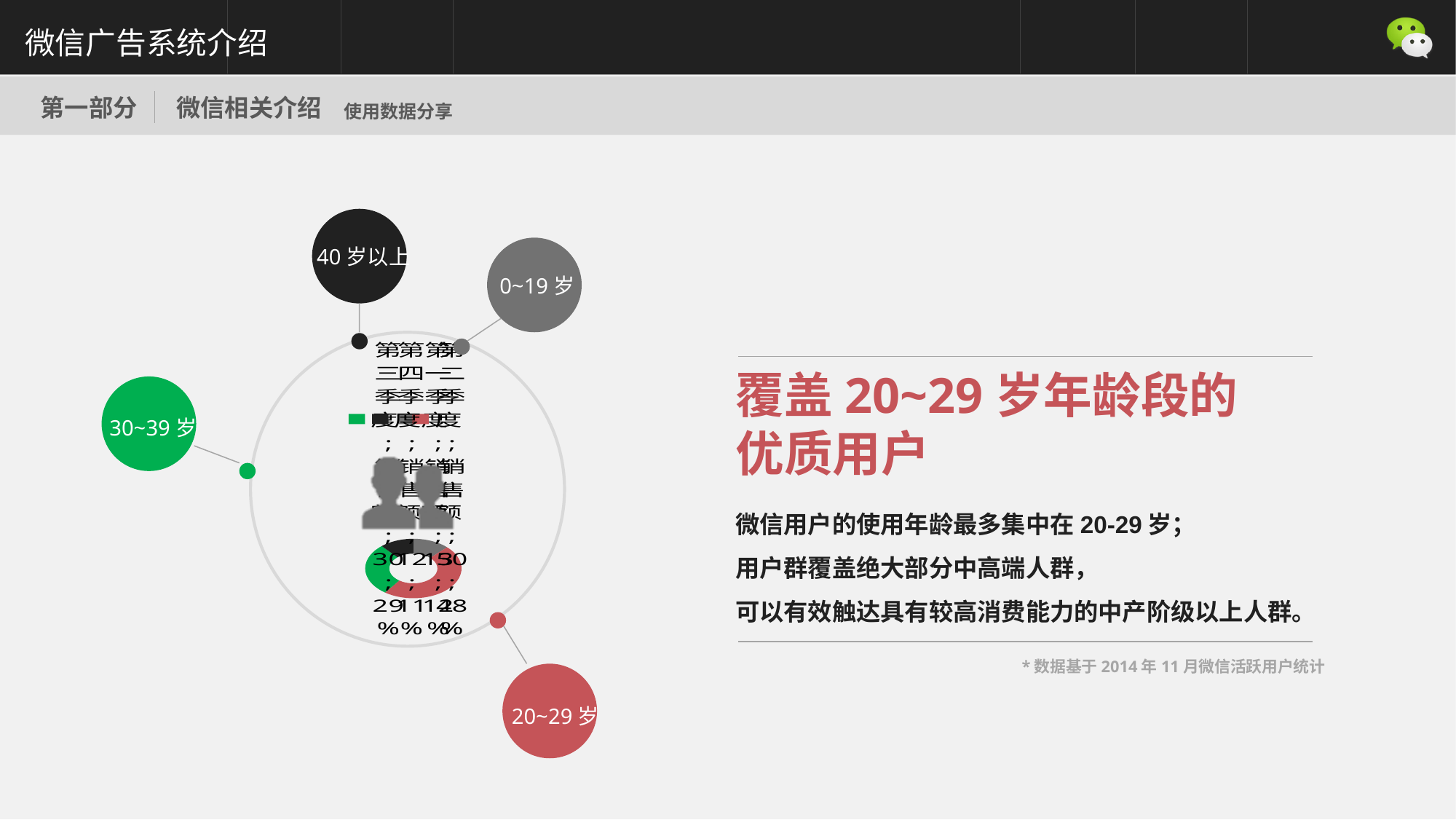
Which slice is larger in the doughnut chart: the one for 40 岁以上 or the one for 20~29 岁? 20~29 岁 How many slices does the doughnut chart have? 4 What kind of chart is shown on the left of the slide? Pie (doughnut) chart Which colour represents the 30~39 岁 age group in the doughnut chart? Green Which age group is represented by the red slice of the doughnut chart? 20~29 岁